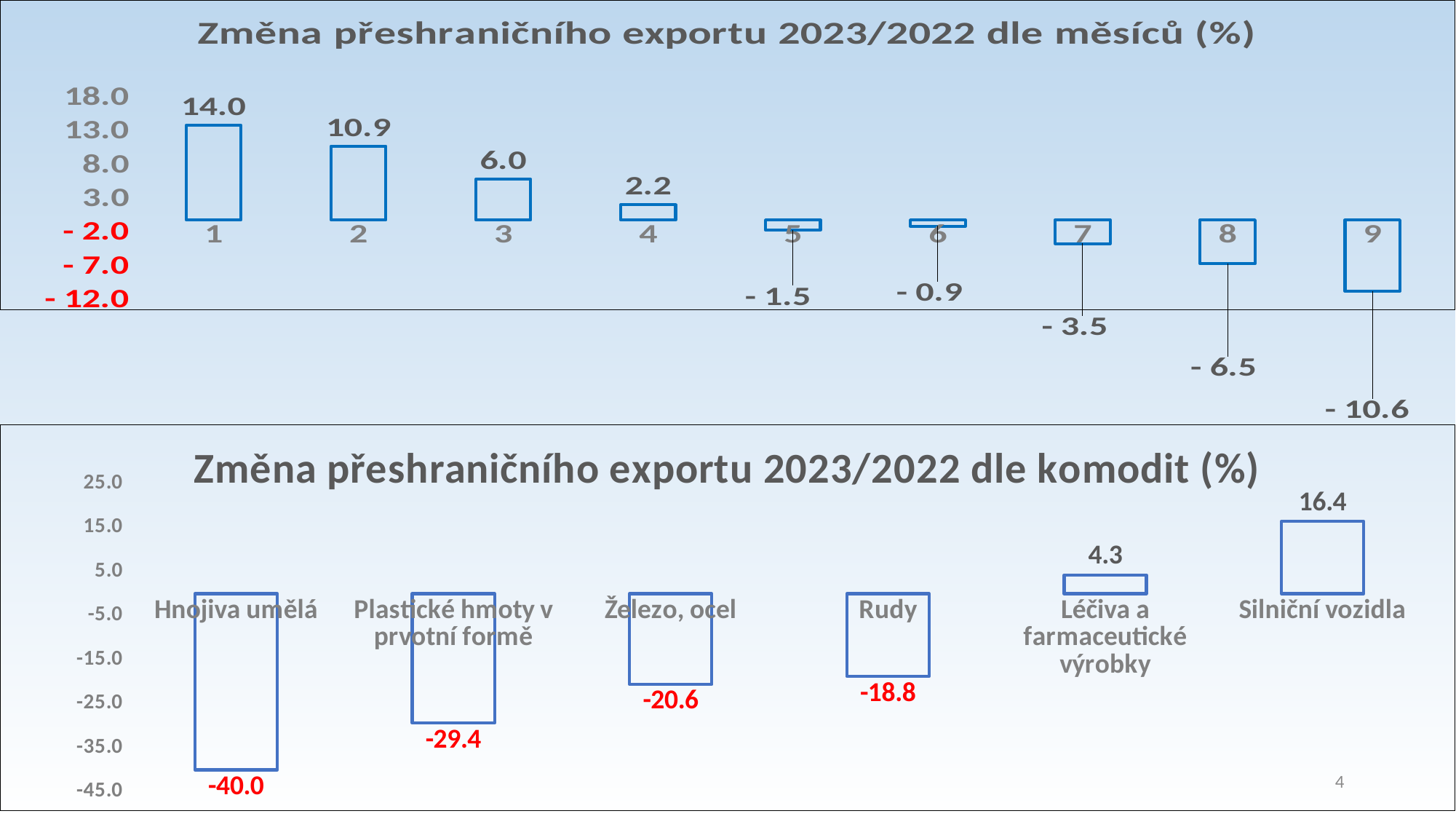
What kind of chart is the bottom chart (dle komodit)? bar chart In the top chart (dle měsíců), do the values rise or fall from month 1 to month 9? fall In the bottom chart (Změna přeshraničního exportu 2023/2022 dle komodit), what is the value for Rudy? -18.8 In the bottom chart (dle komodit), what is the difference between the values for Železo, ocel and Plastické hmoty v prvotní formě? 8.8 In the top chart (dle měsíců), which month has the highest value? 1 In the top chart (dle měsíců), what is the value for month 7? -3.5 In the top chart (Změna přeshraničního exportu 2023/2022 dle měsíců), what is the value for month 1? 14.0 In the top chart (dle měsíců), which month has the lowest value? 9 In the bottom chart (dle komodit), which commodity has the lowest value? Hnojiva umělá In the top chart (dle měsíců), how many months are plotted? 9 In the top chart (dle měsíců), what is the difference between the values for month 2 and month 3? 4.9 In the bottom chart (dle komodit), which is larger, the value for Léčiva a farmaceutické výrobky or Silniční vozidla? Silniční vozidla